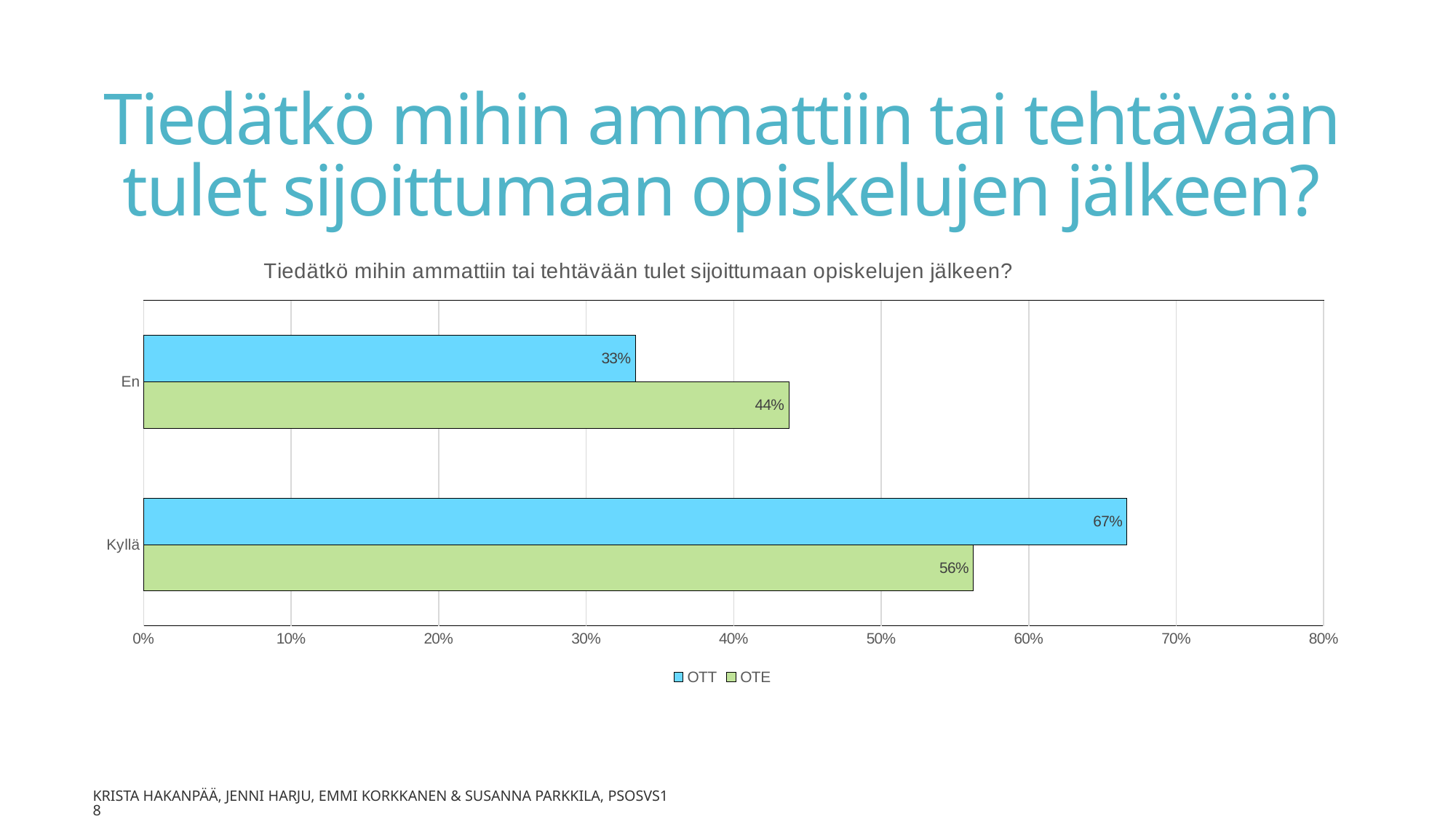
How many series does the legend list? 2 Which category has the highest OTT value? Kyllä What is the OTE value for En? 44% What kind of chart is shown on the slide? Bar chart How many categories are shown on the y axis? 2 What is the difference between the OTT and OTE values for Kyllä? 11% For En, which series has the larger value, OTT or OTE? OTE What is the OTT value for Kyllä? 67% What is the difference between the OTE and OTT values for En? 11% Which category has the lowest OTE value? En What is the OTE value for Kyllä? 56% What is the OTT value for En? 33%